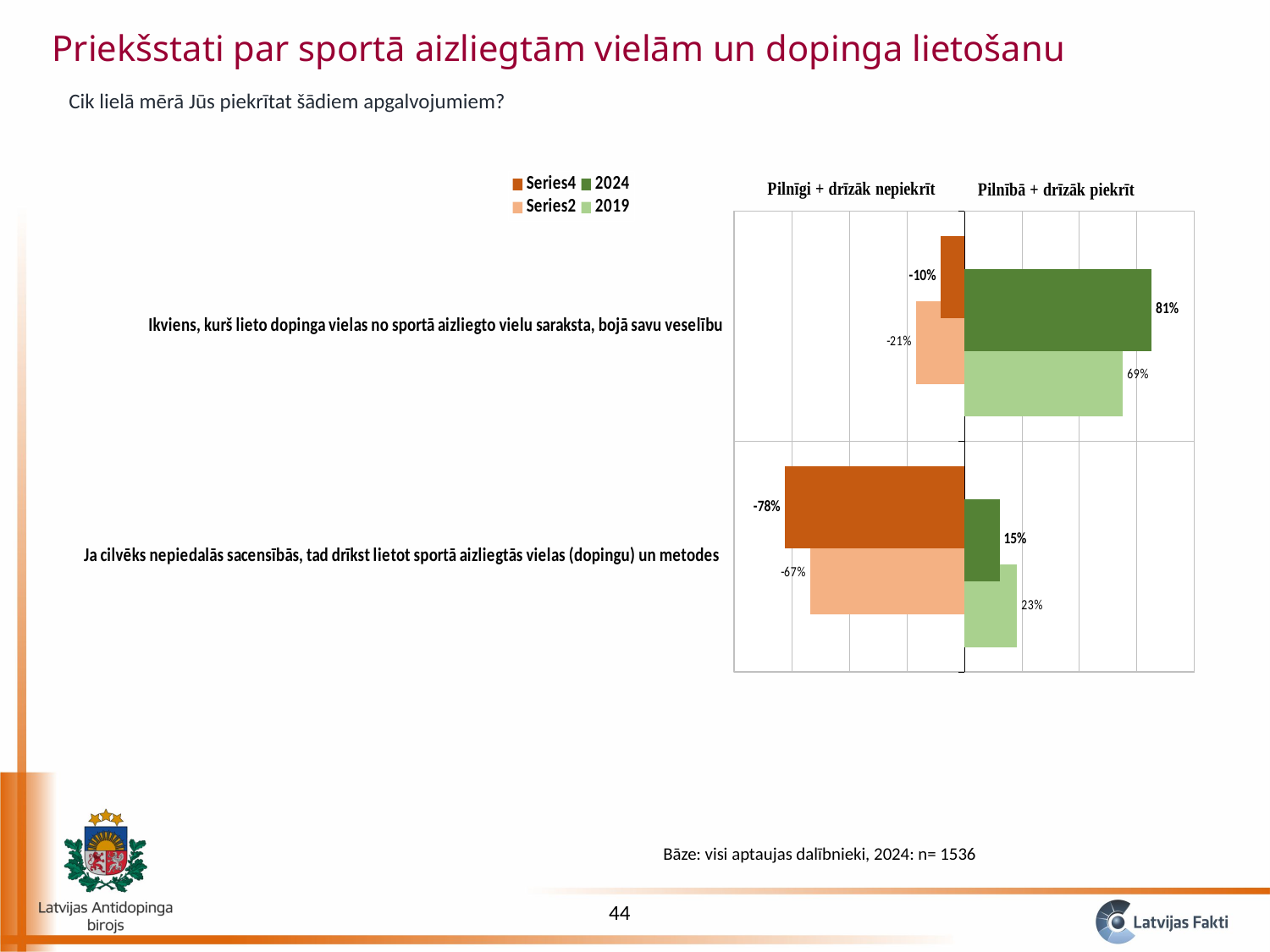
By how many percentage points did agreement (Pilnībā + drīzāk piekrīt) with the statement 'Ikviens, kurš lieto dopinga vielas ... bojā savu veselību' change from 2019 to 2024? 12 percentage points What is the 2024 value for 'Pilnībā + drīzāk piekrīt' for the statement 'Ja cilvēks nepiedalās sacensībās, tad drīkst lietot sportā aizliegtās vielas (dopingu) un metodes'? 15% What is the 2019 value for 'Pilnībā + drīzāk piekrīt' for the statement 'Ja cilvēks nepiedalās sacensībās, tad drīkst lietot sportā aizliegtās vielas (dopingu) un metodes'? 23% Which year shows higher agreement (Pilnībā + drīzāk piekrīt) with the statement 'Ja cilvēks nepiedalās sacensībās, tad drīkst lietot sportā aizliegtās vielas (dopingu) un metodes', 2019 or 2024? 2019 How many statements are shown in the chart? 2 What is the Series2 value (Pilnīgi + drīzāk nepiekrīt) for the statement 'Ikviens, kurš lieto dopinga vielas no sportā aizliegto vielu saraksta, bojā savu veselību'? -21% What is the Series4 value (Pilnīgi + drīzāk nepiekrīt) for the statement 'Ja cilvēks nepiedalās sacensībās, tad drīkst lietot sportā aizliegtās vielas (dopingu) un metodes'? -78% What type of chart is shown on the slide? Bar chart Which statement has the highest 2024 agreement (Pilnībā + drīzāk piekrīt) value? Ikviens, kurš lieto dopinga vielas no sportā aizliegto vielu saraksta, bojā savu veselību What is the 2019 value for 'Pilnībā + drīzāk piekrīt' for the statement 'Ikviens, kurš lieto dopinga vielas no sportā aizliegto vielu saraksta, bojā savu veselību'? 69% What is the 2024 value for 'Pilnībā + drīzāk piekrīt' for the statement 'Ikviens, kurš lieto dopinga vielas no sportā aizliegto vielu saraksta, bojā savu veselību'? 81% How many series does the chart legend list? 4